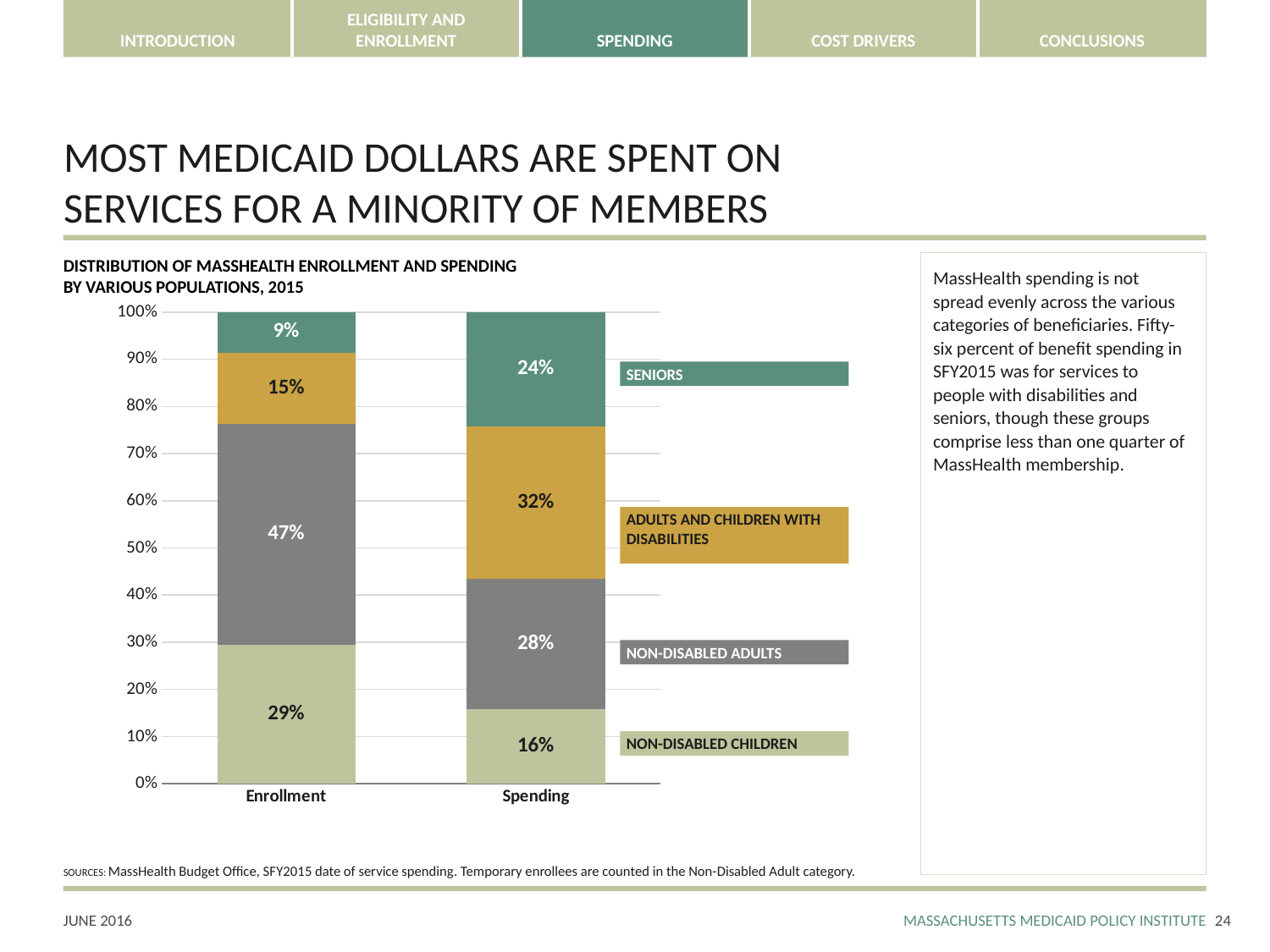
What share of Enrollment is Non-Disabled Children? 29% What share of Enrollment is Non-Disabled Adults? 47% How many populations does the legend list? 4 Which population has the smallest share of Spending? Non-Disabled Children What share of Spending is Seniors? 24% What kind of chart is shown? Stacked bar chart What is the difference between the Seniors share of Spending and the Seniors share of Enrollment? 15 percentage points What share of Spending is Adults and Children with Disabilities? 32% Which is larger: the Non-Disabled Adults share of Enrollment or of Spending? Enrollment Which population has the largest share of Enrollment? Non-Disabled Adults What is the title of the chart? Distribution of MassHealth Enrollment and Spending by Various Populations, 2015 What is the combined share of Spending for Seniors and Adults and Children with Disabilities? 56%